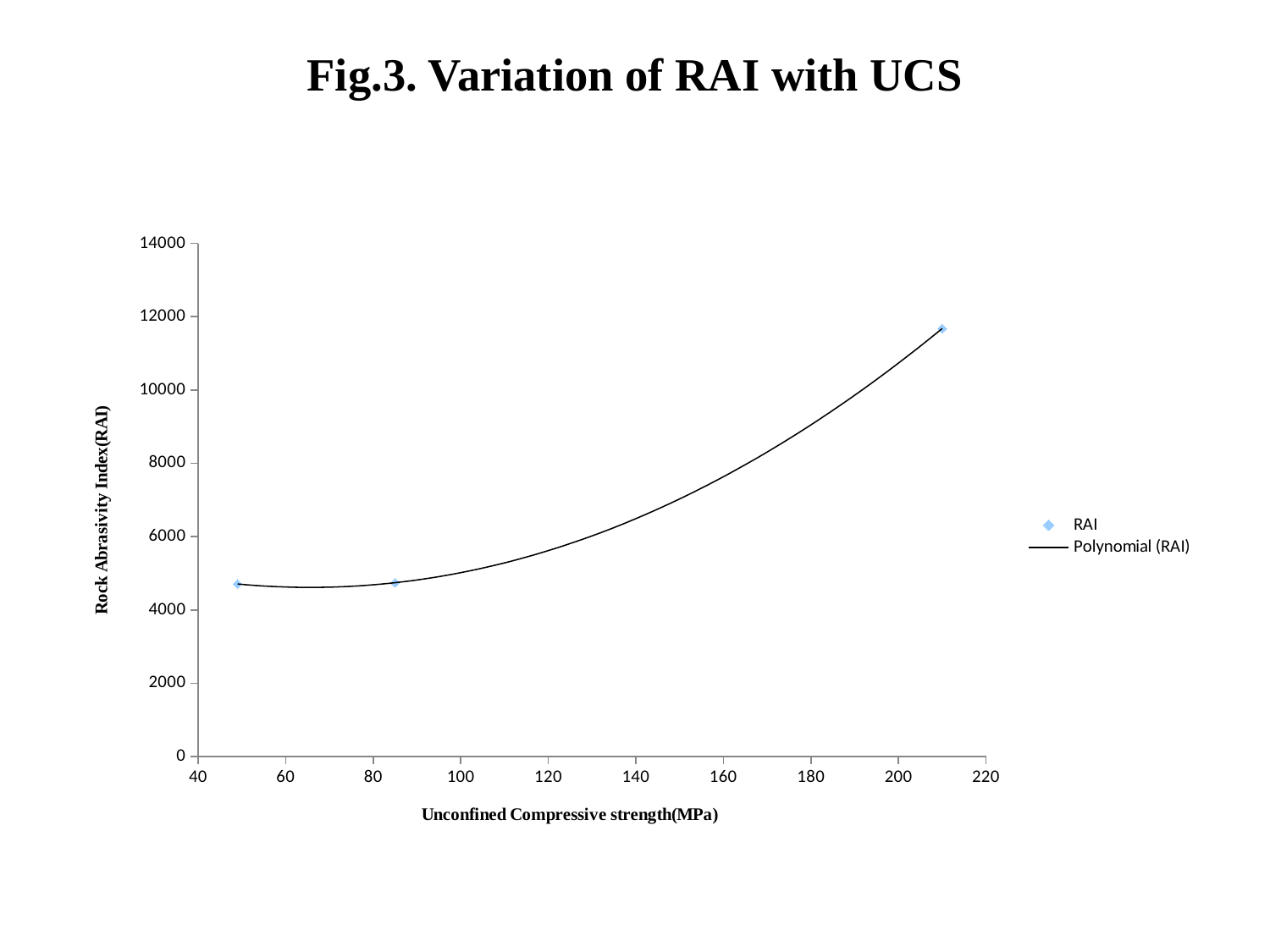
Is the RAI value of the leftmost data point greater or less than 4000? greater Which data point has the highest RAI: the one at the lowest UCS or the one at the highest UCS? the one at the highest UCS What is the title of the chart? Fig.3. Variation of RAI with UCS What is the label of the vertical axis? Rock Abrasivity Index(RAI) How many data points are plotted for the RAI series? 3 What kind of chart is shown on the slide? scatter chart Is the UCS of the rightmost data point greater or less than 200 MPa? greater How many entries does the legend list? 2 Is the RAI value of the leftmost data point (at the lowest UCS) greater or less than 6000? less Does the polynomial trendline rise or fall as UCS increases from 100 MPa to 220 MPa? rise